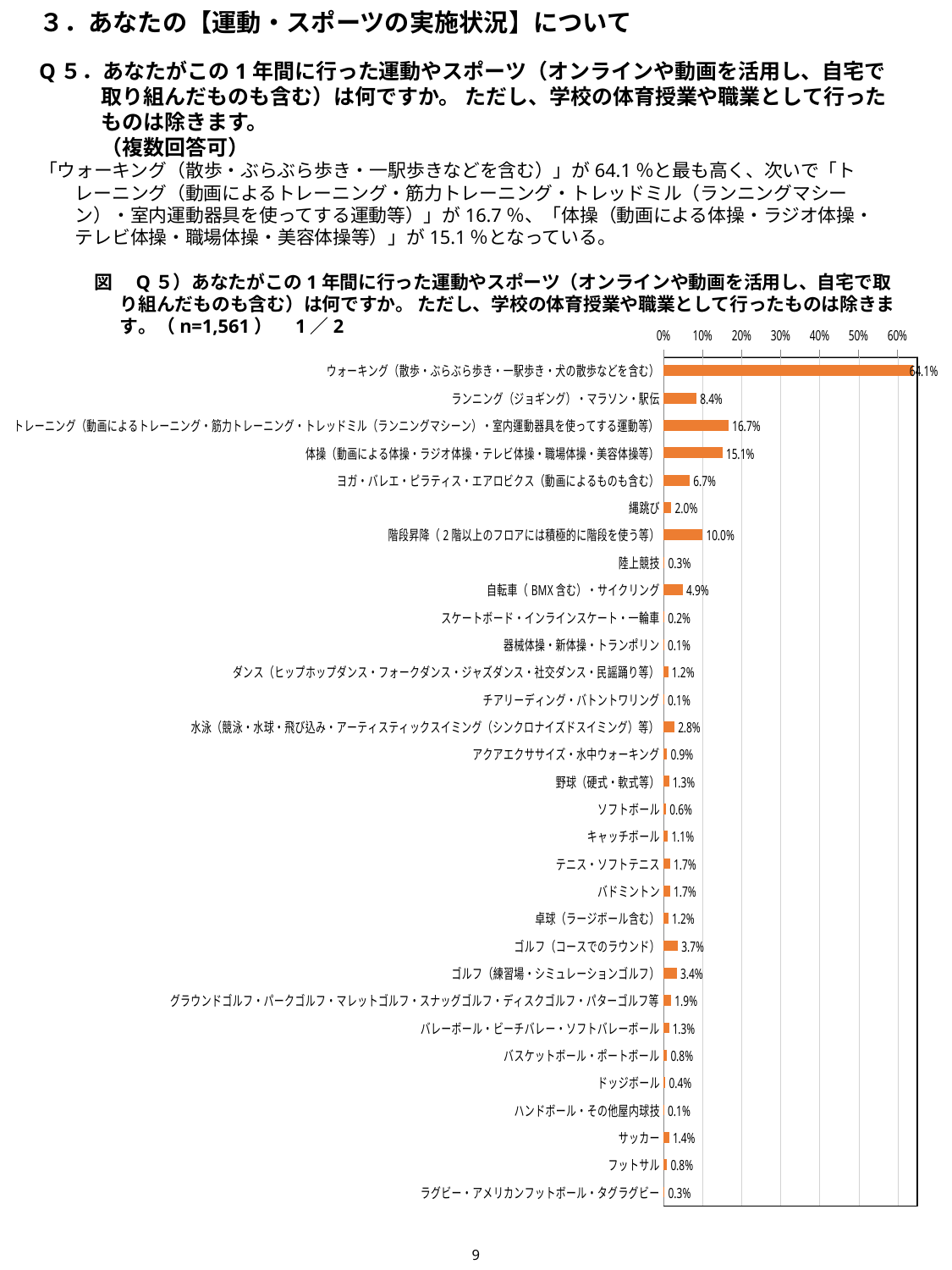
What is the value for ウォーキング（散歩・ぶらぶら歩き・一駅歩き・犬の散歩などを含む）? 64.1% What is the difference between the values for ウォーキング and ランニング（ジョギング）・マラソン・駅伝? 55.7% Which is larger, the value for ヨガ・バレエ・ピラティス・エアロビクス or the value for 自転車（BMX含む）・サイクリング? ヨガ・バレエ・ピラティス・エアロビクス What is the difference between the values for トレーニング and 体操? 1.6% What is the value for 水泳（競泳・水球・飛び込み・アーティスティックスイミング（シンクロナイズドスイミング）等）? 2.8% What is the value for ゴルフ（コースでのラウンド）? 3.7% Is the value for ウォーキング greater or less than 60%? greater How many categories are shown in the chart? 31 Which category has the highest value? ウォーキング（散歩・ぶらぶら歩き・一駅歩き・犬の散歩などを含む） What is the sample size (n) stated in the chart title? 1,561 What kind of chart is shown on the slide? bar chart What is the value for 階段昇降（2階以上のフロアには積極的に階段を使う等）? 10.0%